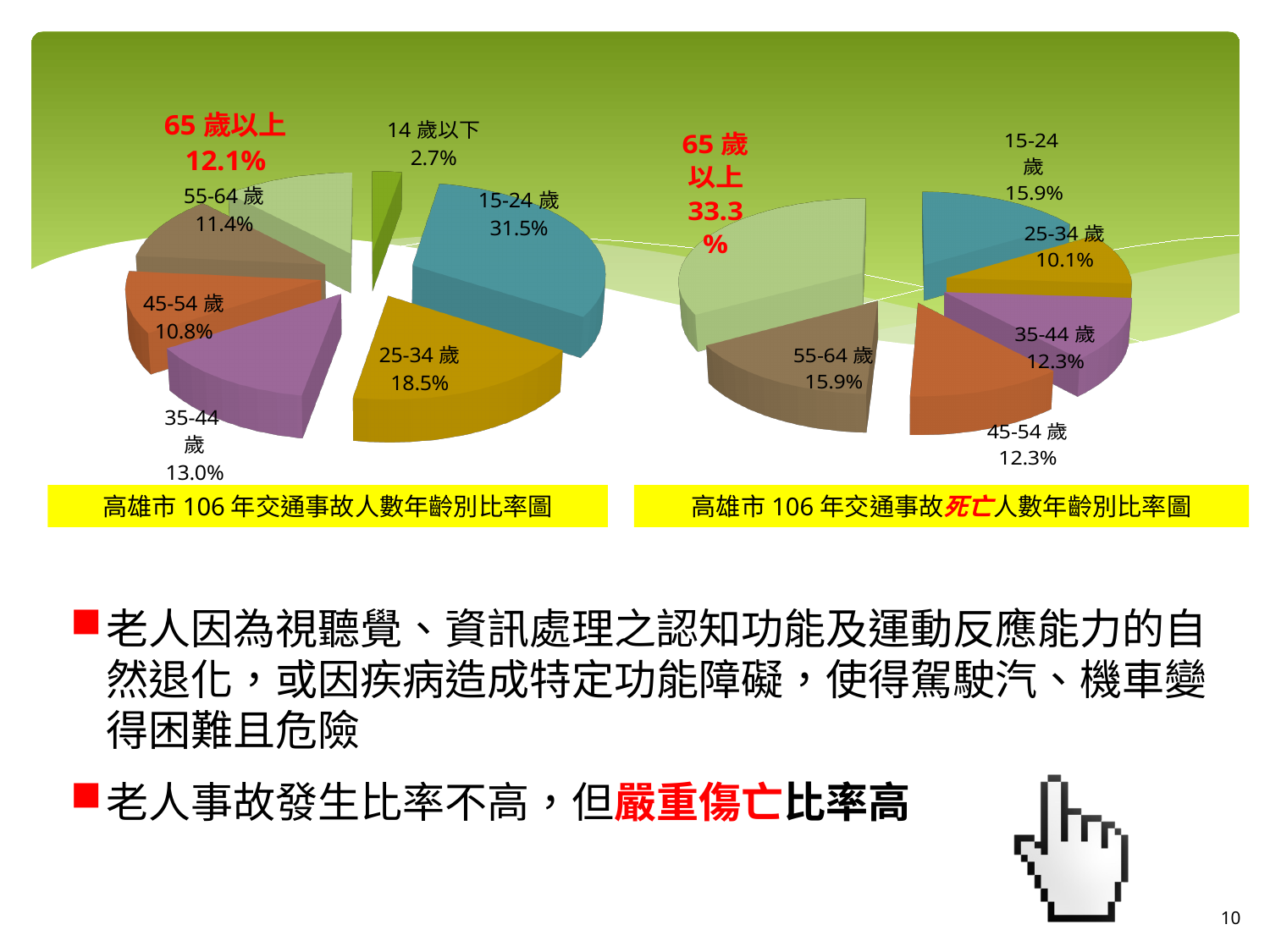
In the left chart (高雄市106年交通事故人數年齡別比率圖), which age group has the largest share? 15-24 歲 In the left chart (高雄市106年交通事故人數年齡別比率圖), what is the difference between the shares for 25-34 歲 and 35-44 歲? 5.5% In the left chart (高雄市106年交通事故人數年齡別比率圖), what share is shown for 15-24 歲? 31.5% In the right chart (高雄市106年交通事故死亡人數年齡別比率圖), how many age groups are shown? 6 In the right chart (高雄市106年交通事故死亡人數年齡別比率圖), which age group has the smallest share? 25-34 歲 What type of chart is used on this slide? Pie chart In the left chart (高雄市106年交通事故人數年齡別比率圖), how many age groups are shown? 7 In the left chart (高雄市106年交通事故人數年齡別比率圖), what share is shown for 65 歲以上? 12.1% Which is larger: the share for 65 歲以上 in the left chart or the share for 65 歲以上 in the right chart? The right chart (33.3%) In the left chart (高雄市106年交通事故人數年齡別比率圖), which age group has the smallest share? 14 歲以下 In the right chart (高雄市106年交通事故死亡人數年齡別比率圖), which age group has the largest share? 65 歲以上 In the right chart (高雄市106年交通事故死亡人數年齡別比率圖), what share is shown for 65 歲以上? 33.3%